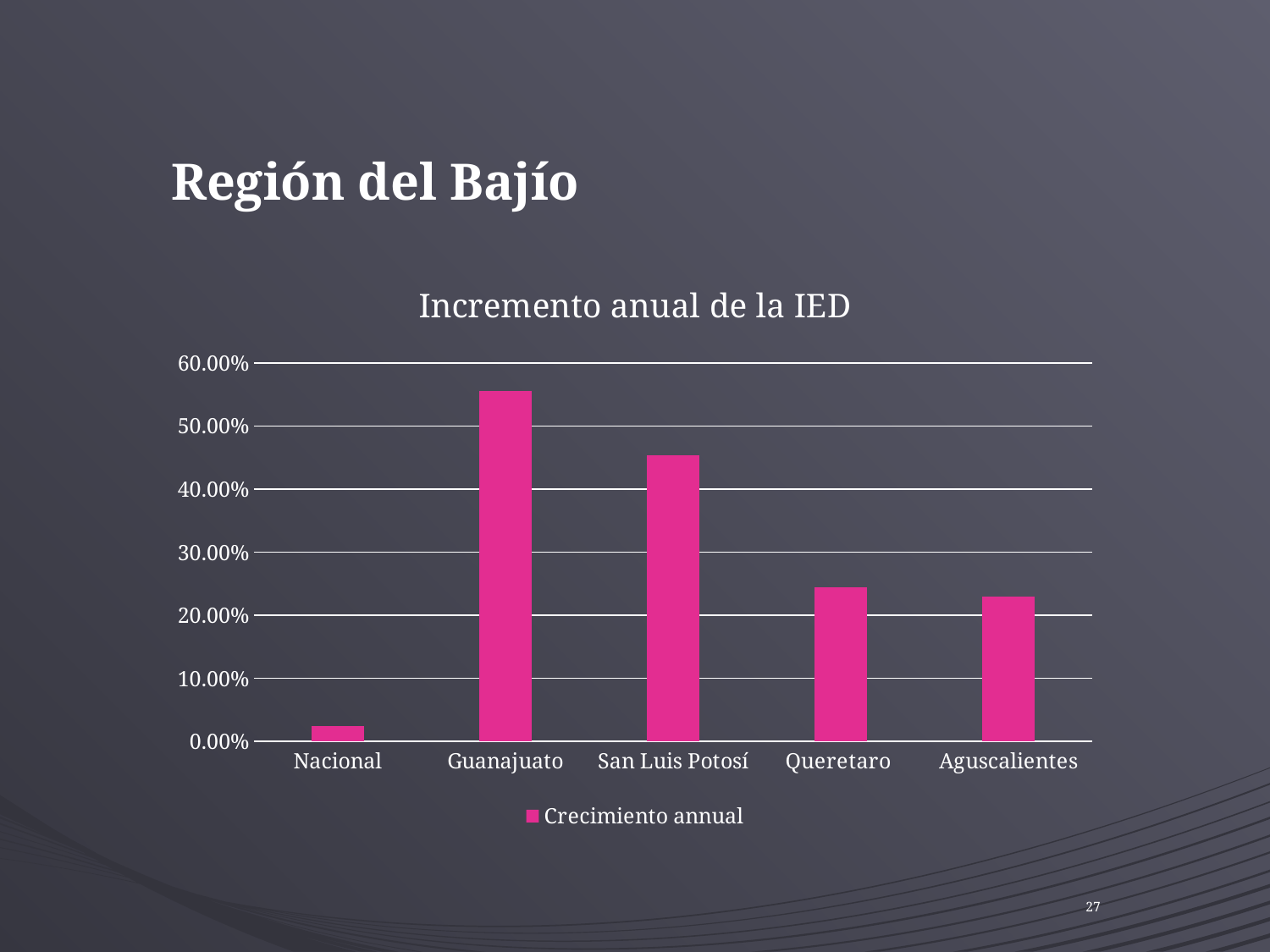
What is the name of the series shown in the legend? Crecimiento annual Which category has the highest value? Guanajuato Is the value for San Luis Potosí greater or less than 40.00%? greater What is the title of the chart? Incremento anual de la IED Is the value for Nacional greater or less than 10.00%? less What kind of chart is shown on the slide? bar chart Which is larger, the value for San Luis Potosí or the value for Queretaro? San Luis Potosí Is the value for Guanajuato greater or less than 50.00%? greater Which category has the lowest value? Nacional How many categories are shown on the x axis of the chart? 5 How many series does the legend list? 1